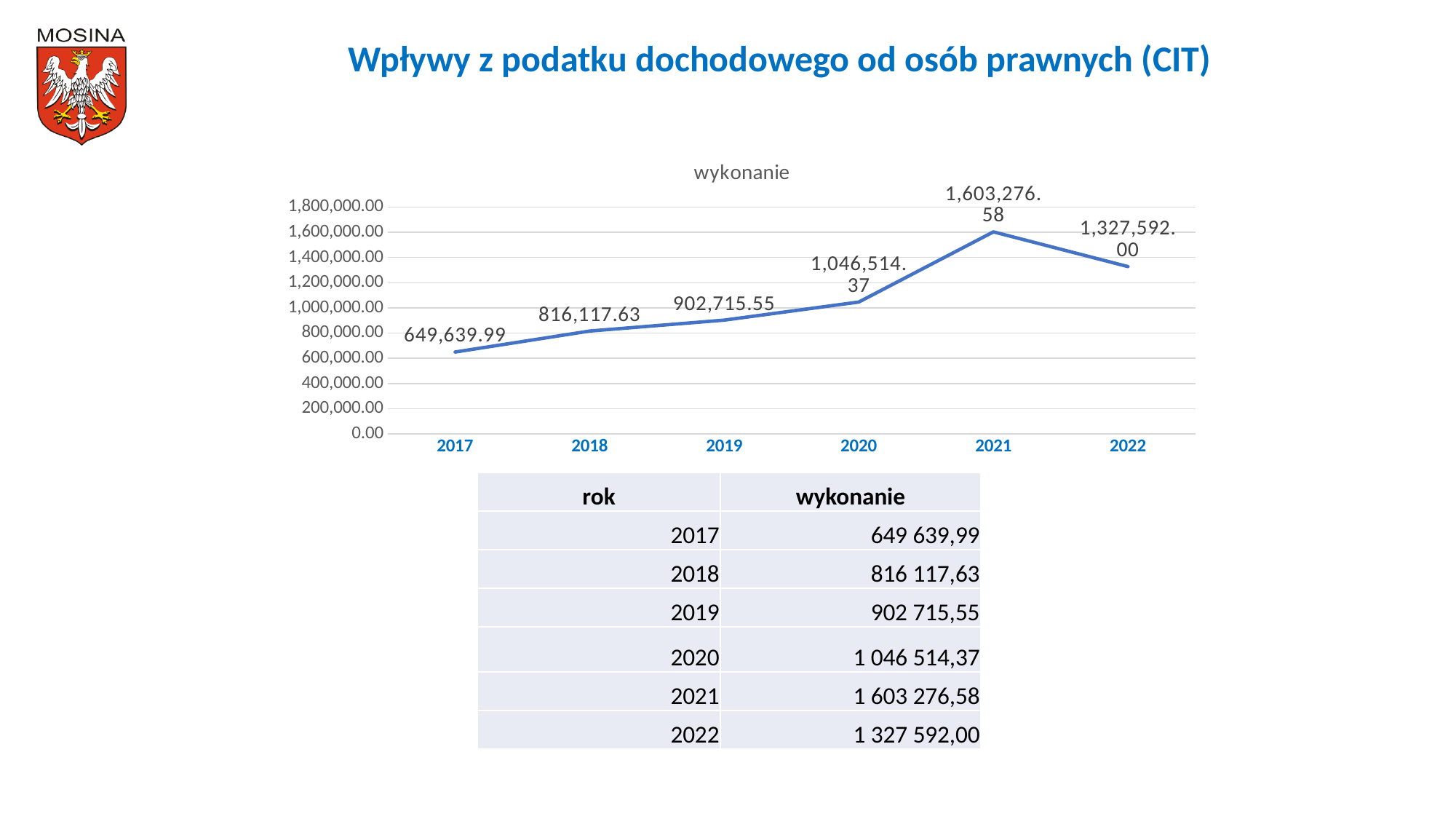
What is the difference between the values for 2018 and 2017? 166,477.64 Which year has the lowest value? 2017 What kind of chart is shown on the slide? line chart What is the value for 2017? 649,639.99 What is the value for 2022? 1,327,592.00 Which is larger, the value for 2020 or the value for 2022? 2022 What is the title of the chart? wykonanie Which year has the highest value? 2021 How many years are plotted on the chart? 6 What is the value for 2021? 1,603,276.58 What is the difference between the values for 2021 and 2022? 275,684.58 What is the value for 2019? 902,715.55